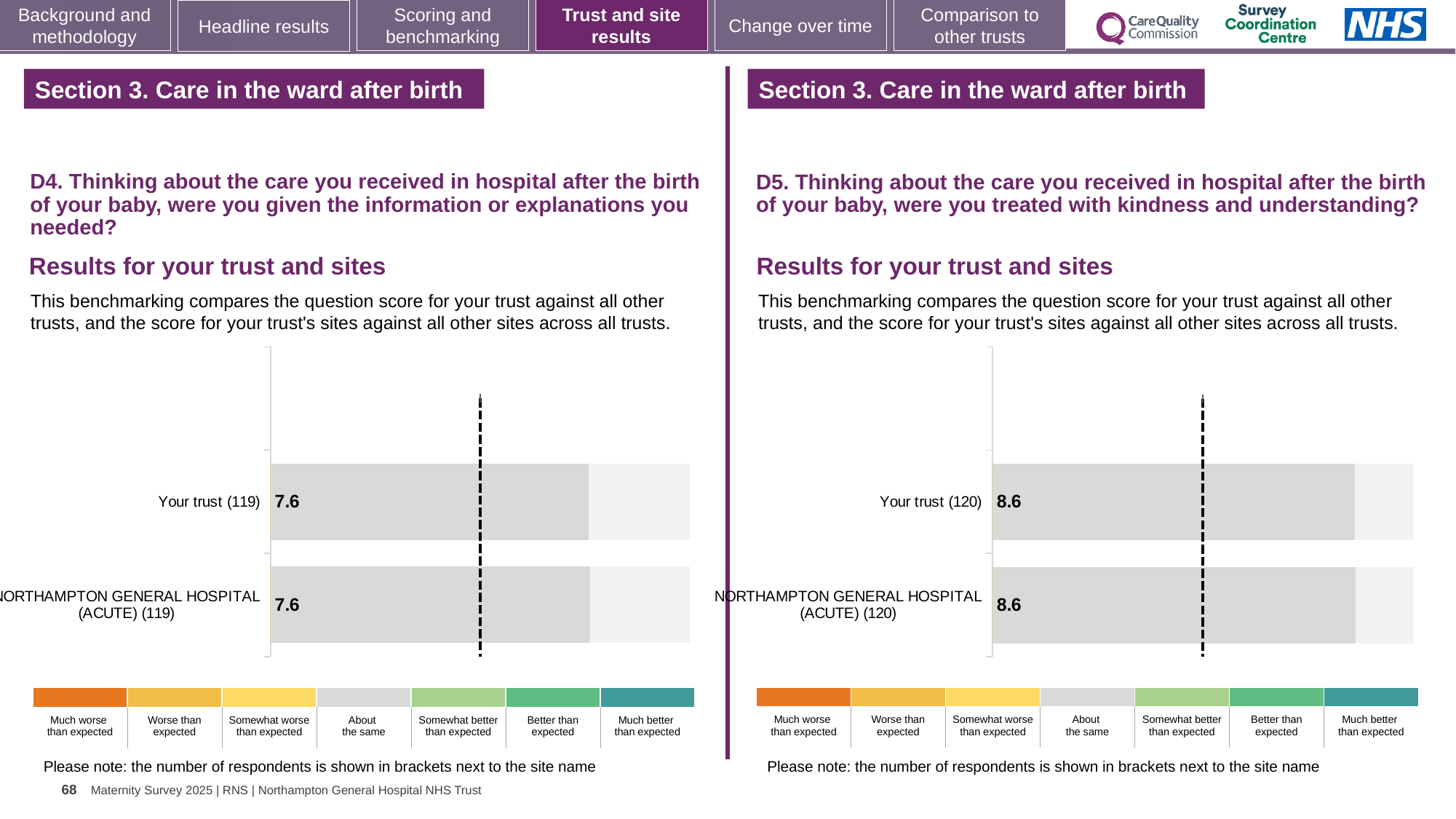
How many categories does the colour key below the D4 chart (left) list? 7 What kind of chart is used on the D5 chart (right)? Bar chart On the D4 chart (left), how many respondents are shown in brackets for Your trust? 119 What is the difference between the Your trust score on the D5 chart (right) and the Your trust score on the D4 chart (left)? 1.0 How many bars are plotted on the D4 chart (left)? 2 Which is larger: the Your trust score on the D4 chart (left) or the Your trust score on the D5 chart (right)? D5 chart (right) On the D4 chart (left), what is the score for Northampton General Hospital (Acute)? 7.6 According to the colour key, which category does the grey colour of the bars on the D5 chart (right) represent? About the same On the D5 chart (right), what is the score for Your trust? 8.6 On the D4 chart (left), what is the score for Your trust? 7.6 On the D5 chart (right), how many respondents are shown in brackets for Northampton General Hospital (Acute)? 120 On the D5 chart (right), what is the score for Northampton General Hospital (Acute)? 8.6